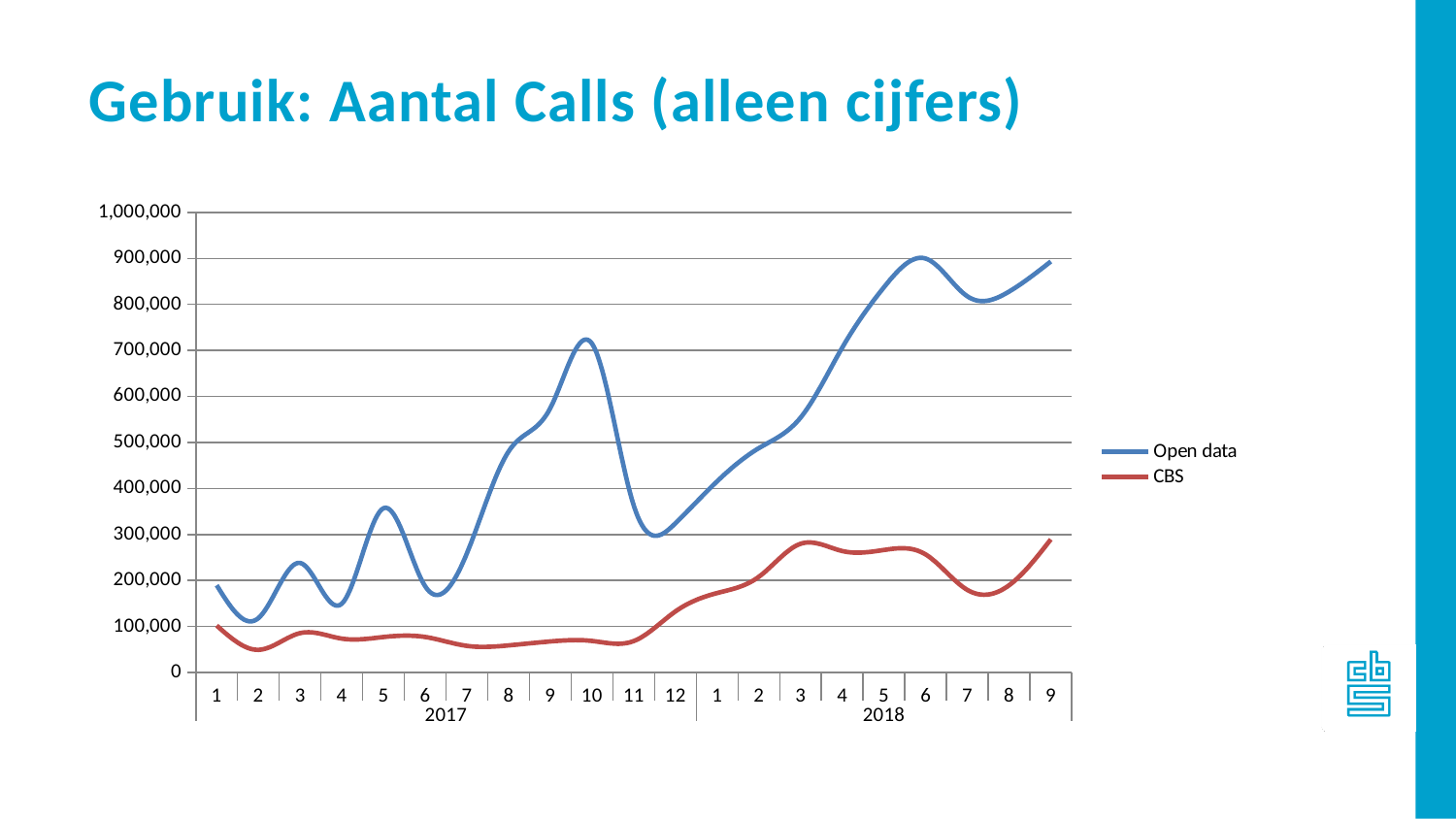
Is the value for Open data in month 10 of 2017 greater or less than 600,000? greater Is the value for CBS in month 3 of 2018 greater or less than 300,000? less Is the value for CBS in month 7 of 2017 greater or less than 100,000? less How many series does the legend list? 2 What is the title of the slide? Gebruik: Aantal Calls (alleen cijfers) For Open data, which is larger: the value in month 10 of 2017 or the value in month 12 of 2017? Month 10 of 2017 How many months are plotted along the x axis in total? 21 Which series has the higher value in month 9 of 2018, Open data or CBS? Open data Which series are listed in the legend? Open data and CBS What kind of chart is shown on the slide? Line chart Does the CBS line rise or fall from month 12 of 2017 to month 3 of 2018? Rise